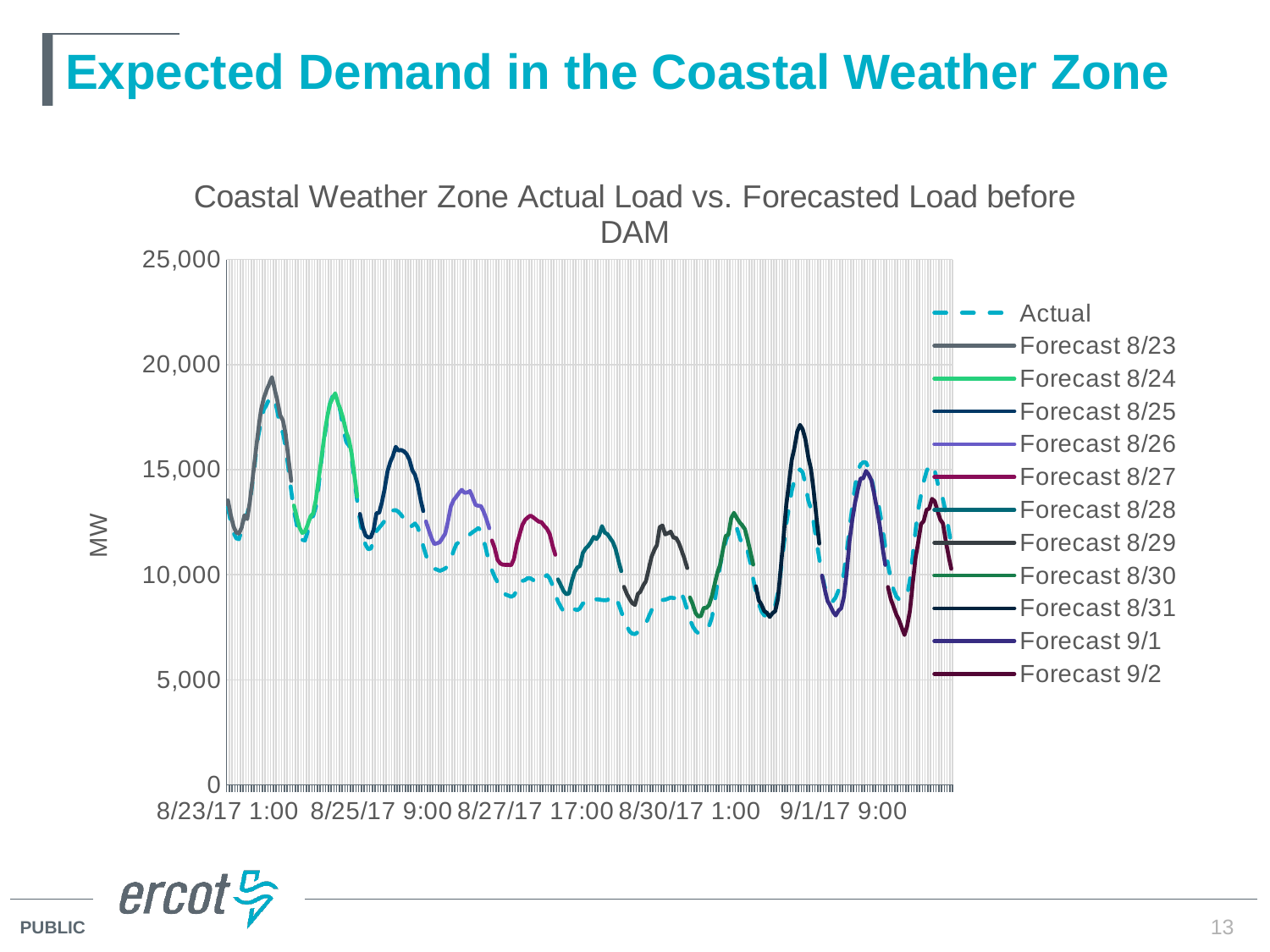
Which has the higher peak, the Forecast 8/23 line or the Forecast 8/31 line? Forecast 8/23 Does the Actual load generally rise or fall from 8/23/17 to 8/27/17? fall Is the lowest value of the Actual line greater or less than 10,000? less Is the peak value of the Forecast 8/31 line greater or less than 15,000? greater What is the label on the vertical axis? MW Is the lowest value of the Forecast 9/2 line greater or less than 10,000? less What is the title of the chart? Coastal Weather Zone Actual Load vs. Forecasted Load before DAM What kind of chart is shown on the slide? Line chart How many series does the legend list? 12